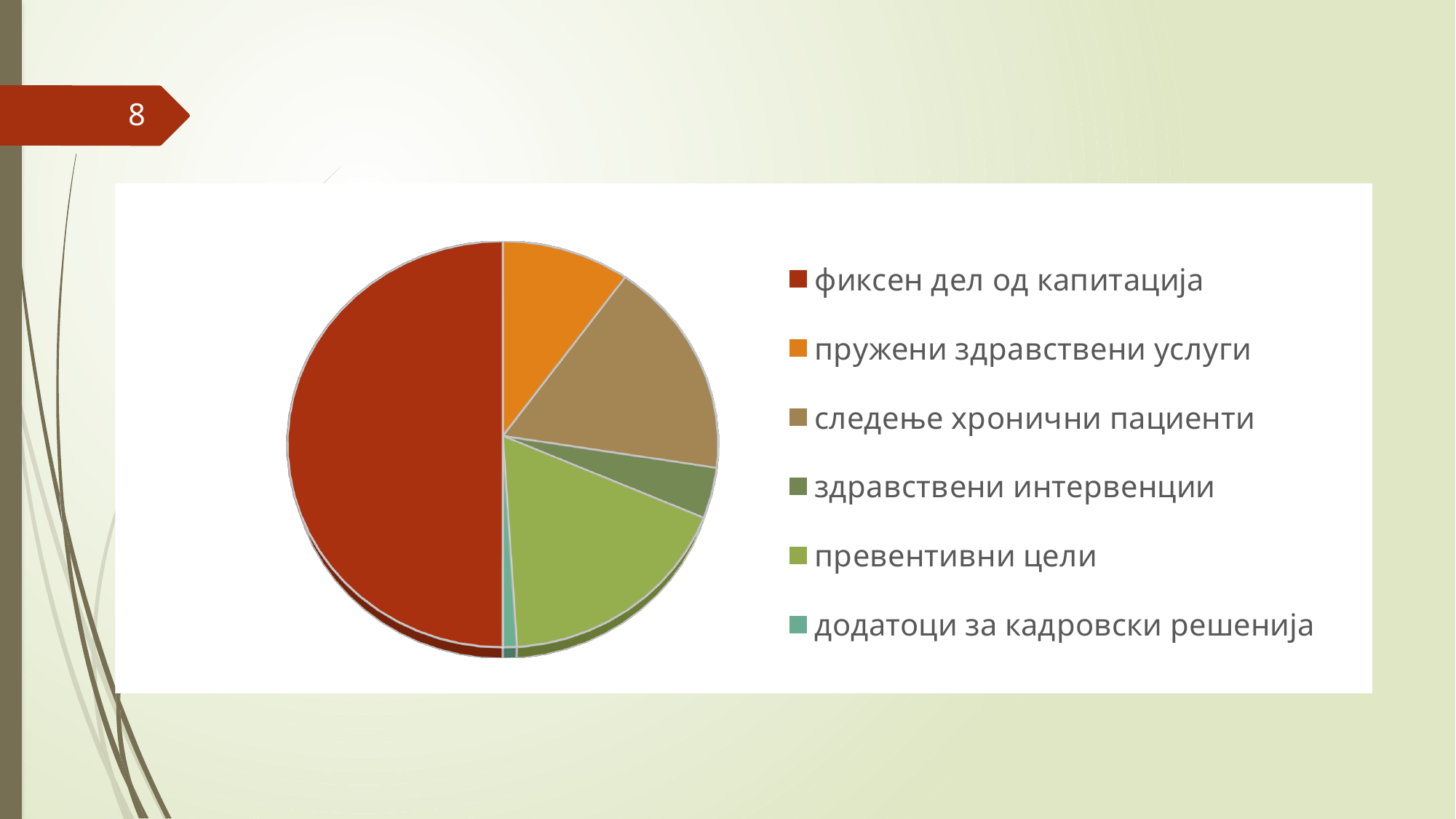
Which legend entry is listed first in the pie chart's legend? фиксен дел од капитација Which slice is larger: "здравствени интервенции" or "додатоци за кадровски решенија"? здравствени интервенции Which category has the smallest slice of the pie chart? додатоци за кадровски решенија Which slice is larger: "фиксен дел од капитација" or "превентивни цели"? фиксен дел од капитација Which category has the largest slice of the pie chart? фиксен дел од капитација How many slices does the pie chart have? 6 Which slice is larger: "пружени здравствени услуги" or "следење хронични пациенти"? следење хронични пациенти How many entries does the legend of the pie chart list? 6 What kind of chart is shown on the slide? pie chart What colour is the slice for "пружени здравствени услуги" in the pie chart? orange